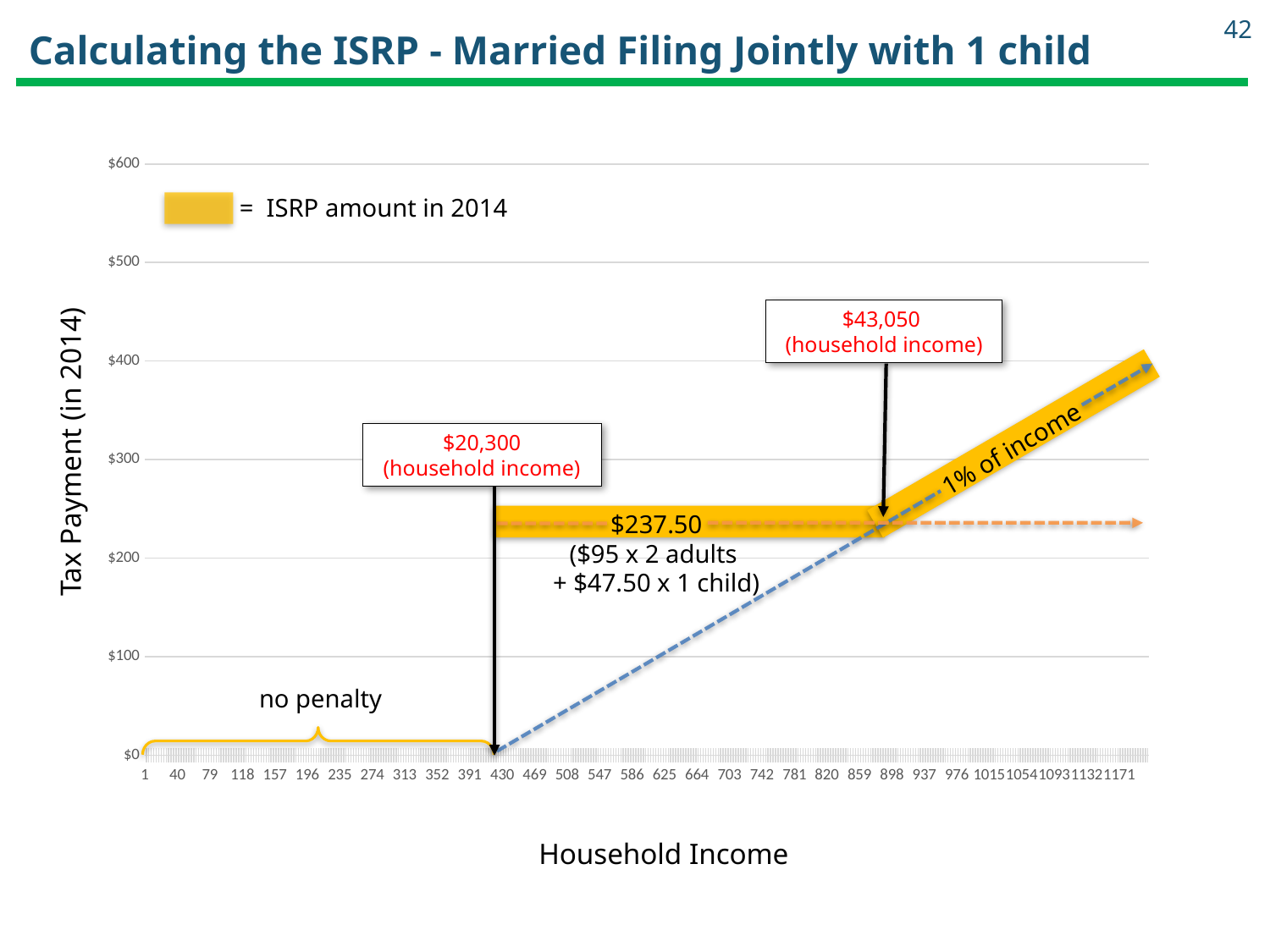
What does the yellow legend swatch represent? ISRP amount in 2014 At what household income does the ISRP switch to 1% of income? $43,050 What is the title of the y axis? Tax Payment (in 2014) What kind of chart is shown on the slide? line chart What is the per-adult amount used to compute the $237.50 penalty? $95 At what household income does the ISRP penalty begin, according to the chart? $20,300 What is the per-child amount used to compute the $237.50 penalty? $47.50 What is the flat ISRP amount shown for household incomes between $20,300 and $43,050? $237.50 Is the flat ISRP amount of $237.50 greater or less than $200 on the y axis? greater For household incomes above $43,050, does the ISRP amount rise or fall as income increases? rise Is the flat ISRP amount of $237.50 greater or less than $300 on the y axis? less What does the chart show as the penalty for household incomes below $20,300? no penalty